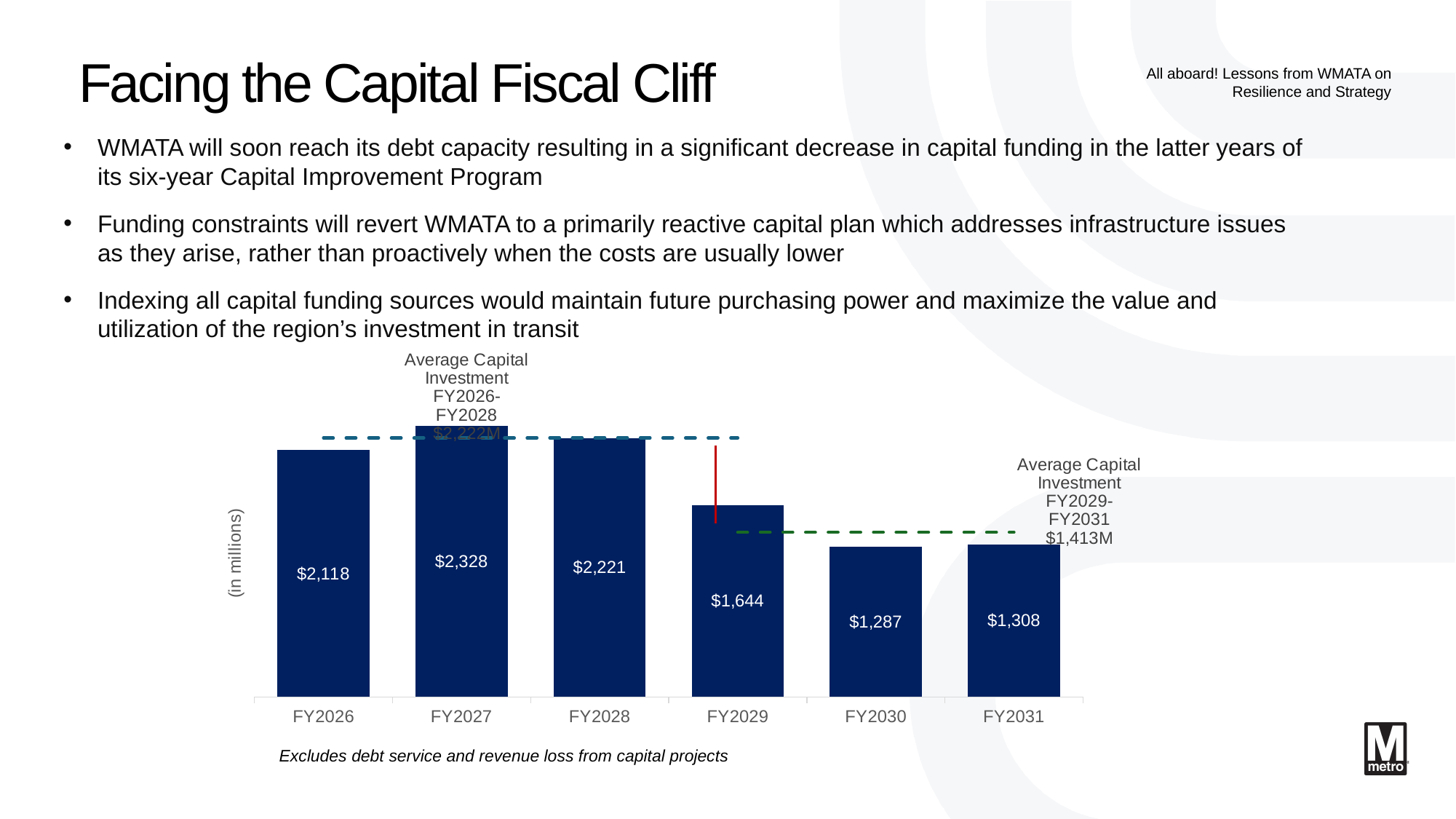
What is the Average Capital Investment for FY2029-FY2031 shown on the chart? $1,413M What is the value for FY2030? $1,287 Which is larger, the value for FY2026 or the value for FY2031? FY2026 What kind of chart is shown on the slide? Bar chart What is the difference between the values for FY2028 and FY2029? $577 Which fiscal year has the lowest value? FY2030 What unit is given on the y axis label of the chart? in millions How many fiscal years are shown on the x axis? 6 Do the values generally rise or fall from FY2028 to FY2030? Fall What is the value for FY2027? $2,328 Which fiscal year has the highest value? FY2027 What is the value for FY2029? $1,644